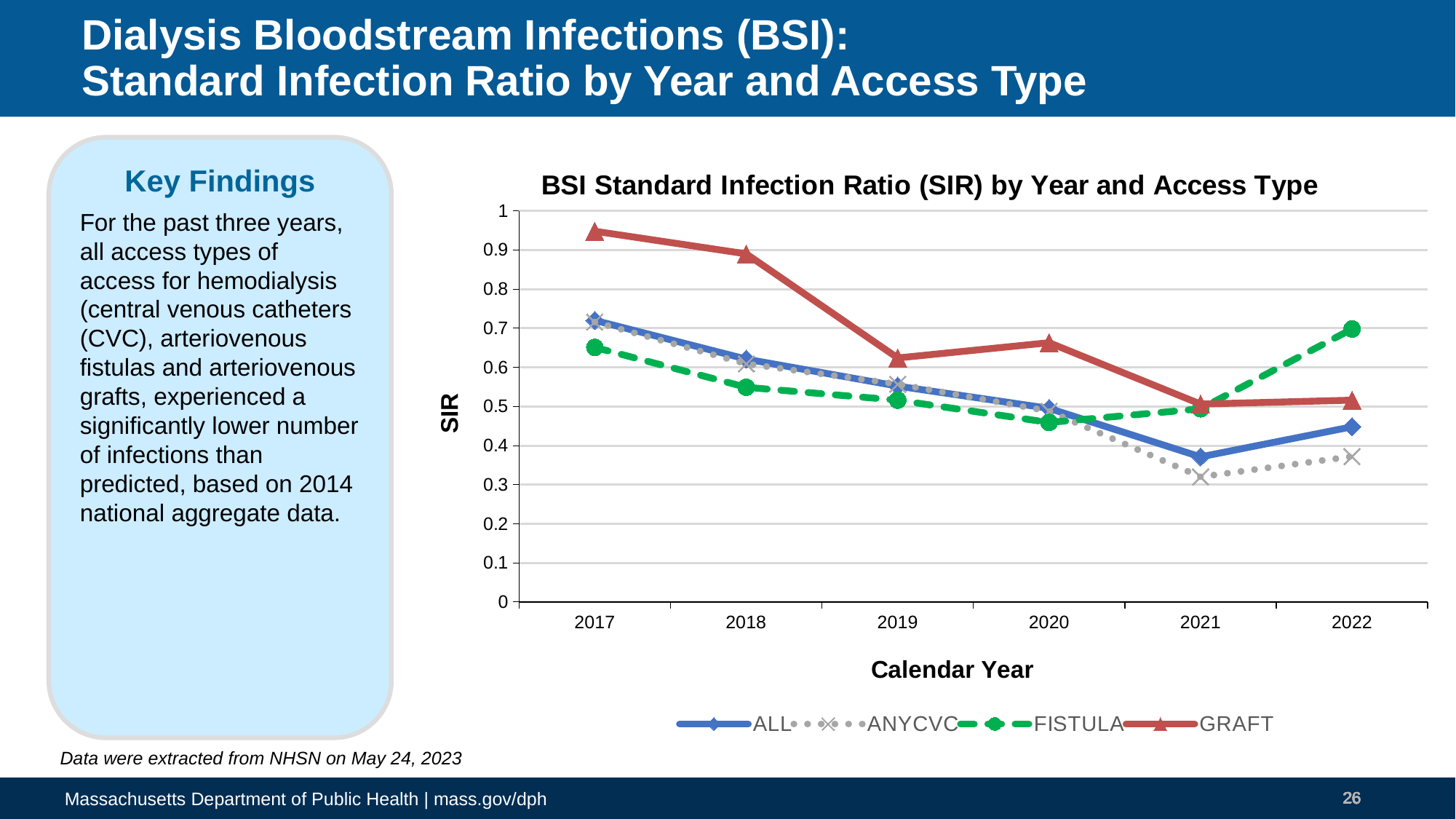
In 2022, which has the larger SIR, FISTULA or GRAFT? FISTULA Which access type has the highest SIR in 2017? GRAFT Which access type has the highest SIR in 2022? FISTULA What is the title of the x axis? Calendar Year What kind of chart is shown on the slide? line chart How many series does the legend list? 4 How many calendar years are plotted on the x axis? 6 Which access type has the lowest SIR in 2021? ANYCVC Is the SIR for ANYCVC in 2021 greater or less than 0.4? less Is the SIR for FISTULA in 2022 greater or less than 0.6? greater Does the SIR for GRAFT rise or fall from 2017 to 2021? fall Is the SIR for GRAFT in 2017 greater or less than 0.9? greater